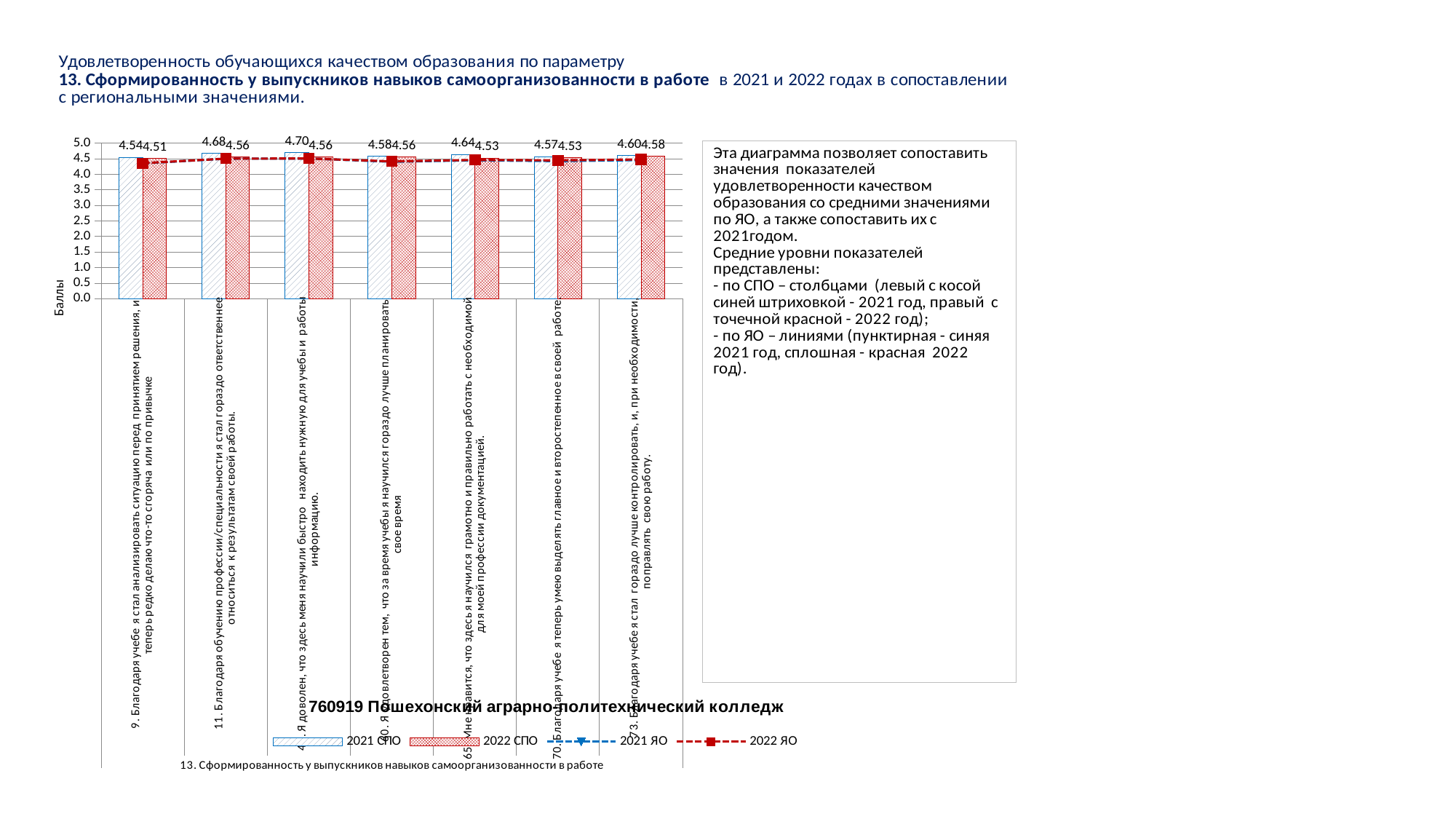
How many series does the chart legend list? 4 What is the 2021 СПО value for statement 9 ("Благодаря учебе я стал анализировать ситуацию перед принятием решения...")? 4.54 What is the 2022 СПО value for statement 73 ("Благодаря учебе я стал гораздо лучше контролировать, и, при необходимости, поправлять свою работу")? 4.58 What is the difference between the 2021 СПО and 2022 СПО values for statement 70 ("Благодаря учебе я теперь умею выделять главное и второстепенное в своей работе")? 0.04 What is the label of the vertical (y) axis of the chart? Баллы Which statement has the lowest 2021 СПО value? 9. Благодаря учебе я стал анализировать ситуацию перед принятием решения... (4.54) Is the 2021 СПО value for statement 11 greater or less than 4.0? greater What is the 2022 СПО value for statement 11 ("Благодаря обучению профессии/специальности я стал гораздо ответственнее относиться к результатам своей работы")? 4.56 What kind of chart is shown on the slide? combination bar and line chart How many categories (statements) are plotted along the x axis of the chart? 7 Which statement has the highest 2021 СПО value? Я доволен, что здесь меня научили быстро находить нужную для учебы и работы информацию (4.70) What is the 2021 СПО value for statement 65 ("Мне нравится, что здесь я научился грамотно и правильно работать с необходимой для моей профессии документацией")? 4.64